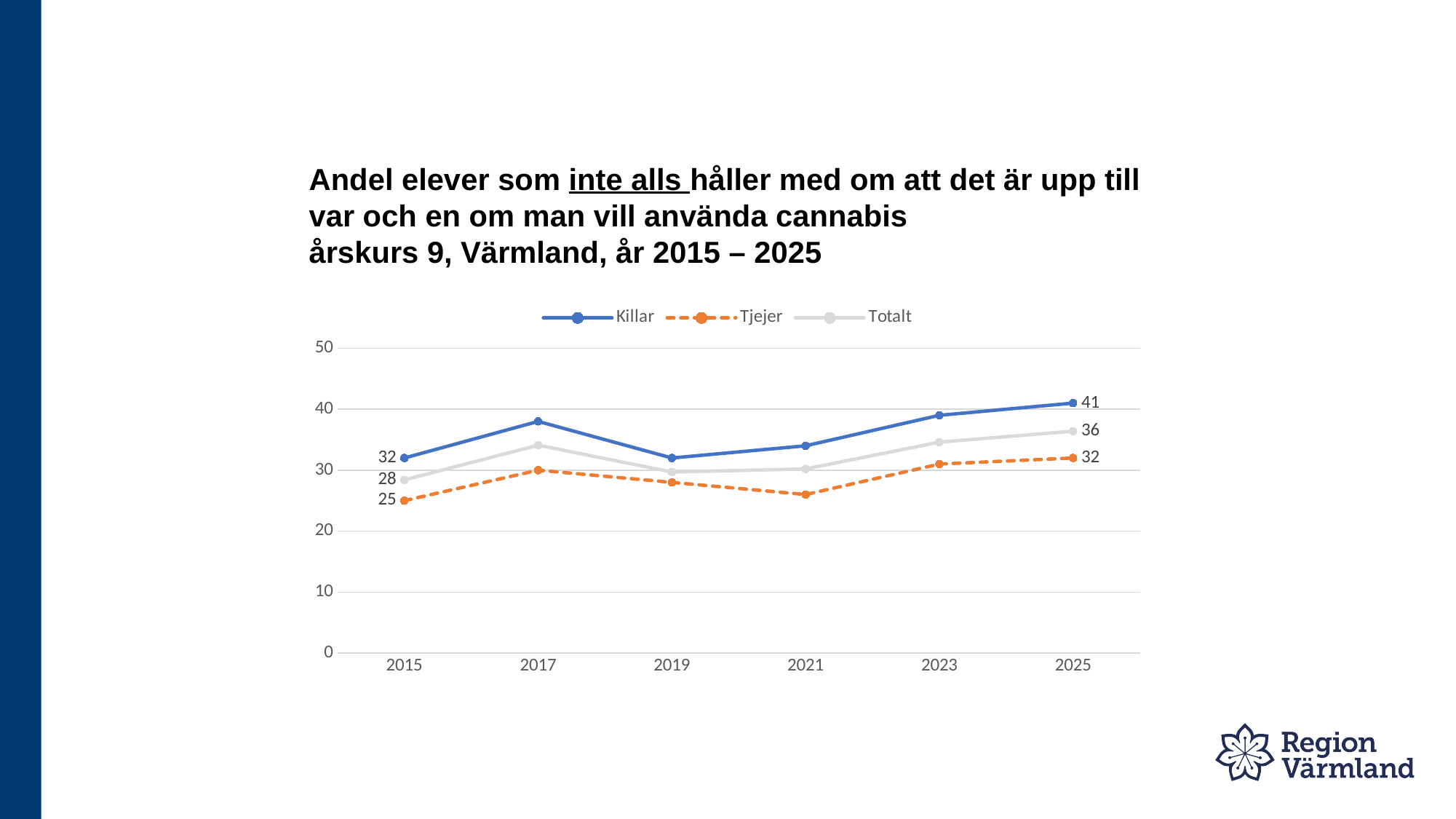
Which series has the lowest value in 2015? Tjejer What is the value for Tjejer in 2025? 32 How many years are shown on the x axis? 6 Which series has the highest value in 2025? Killar What kind of chart is shown on the slide? line chart What is the value for Totalt in 2015? 28 Which is larger in 2015: the value for Tjejer or the value for Totalt? Totalt What is the value for Killar in 2025? 41 What is the value for Killar in 2015? 32 How many series does the legend list? 3 Is the value for Tjejer in 2021 greater or less than 30? less What is the difference between the Killar value in 2025 and the Killar value in 2015? 9